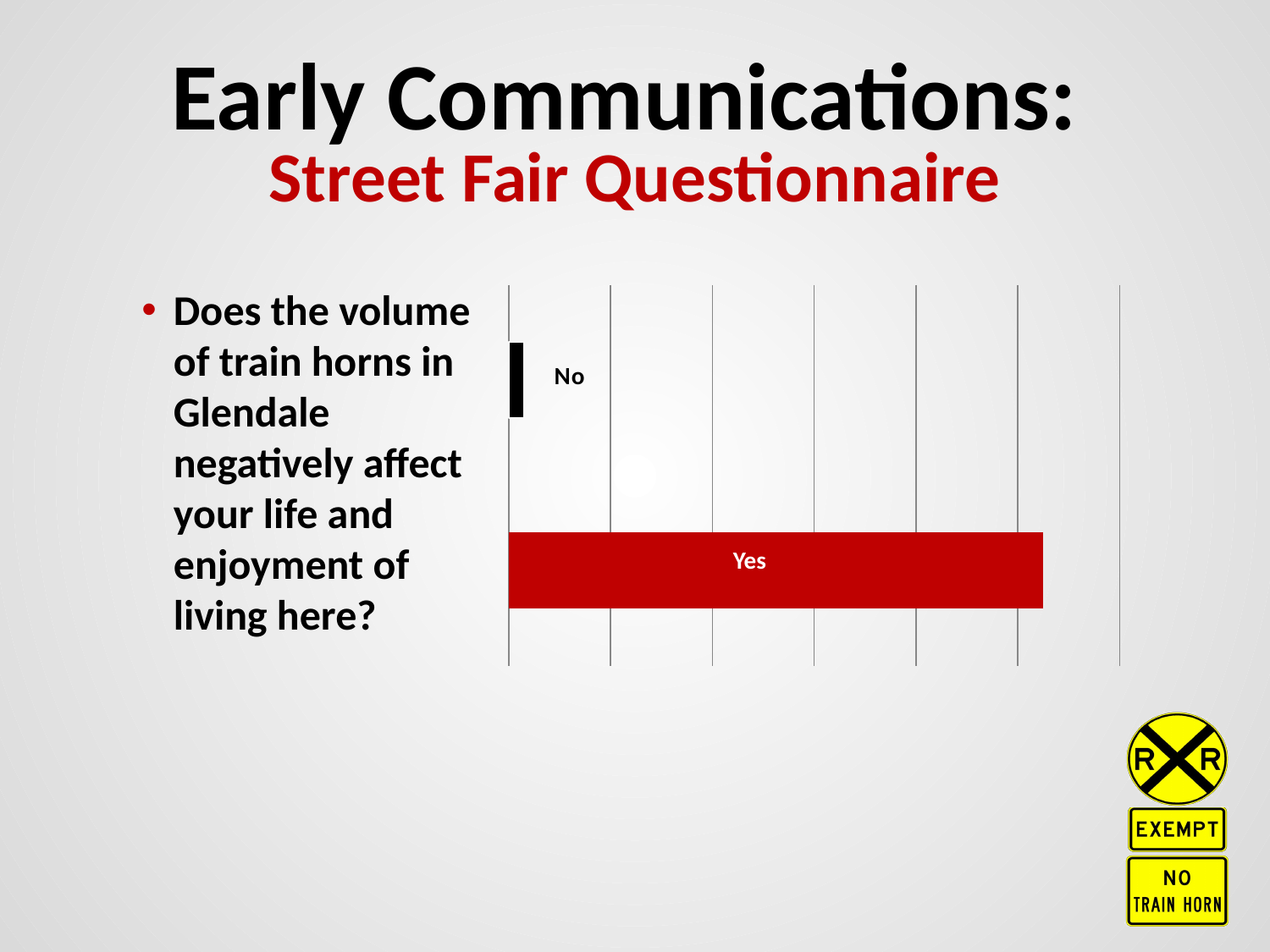
Which is larger, the value for Yes or the value for No? Yes Which category has the highest value in the chart? Yes How many categories (bars) does the chart show? 2 What kind of chart is shown on the slide? bar chart What colour is the No bar in the chart? black Which category has the lowest value in the chart? No What colour is the Yes bar in the chart? red